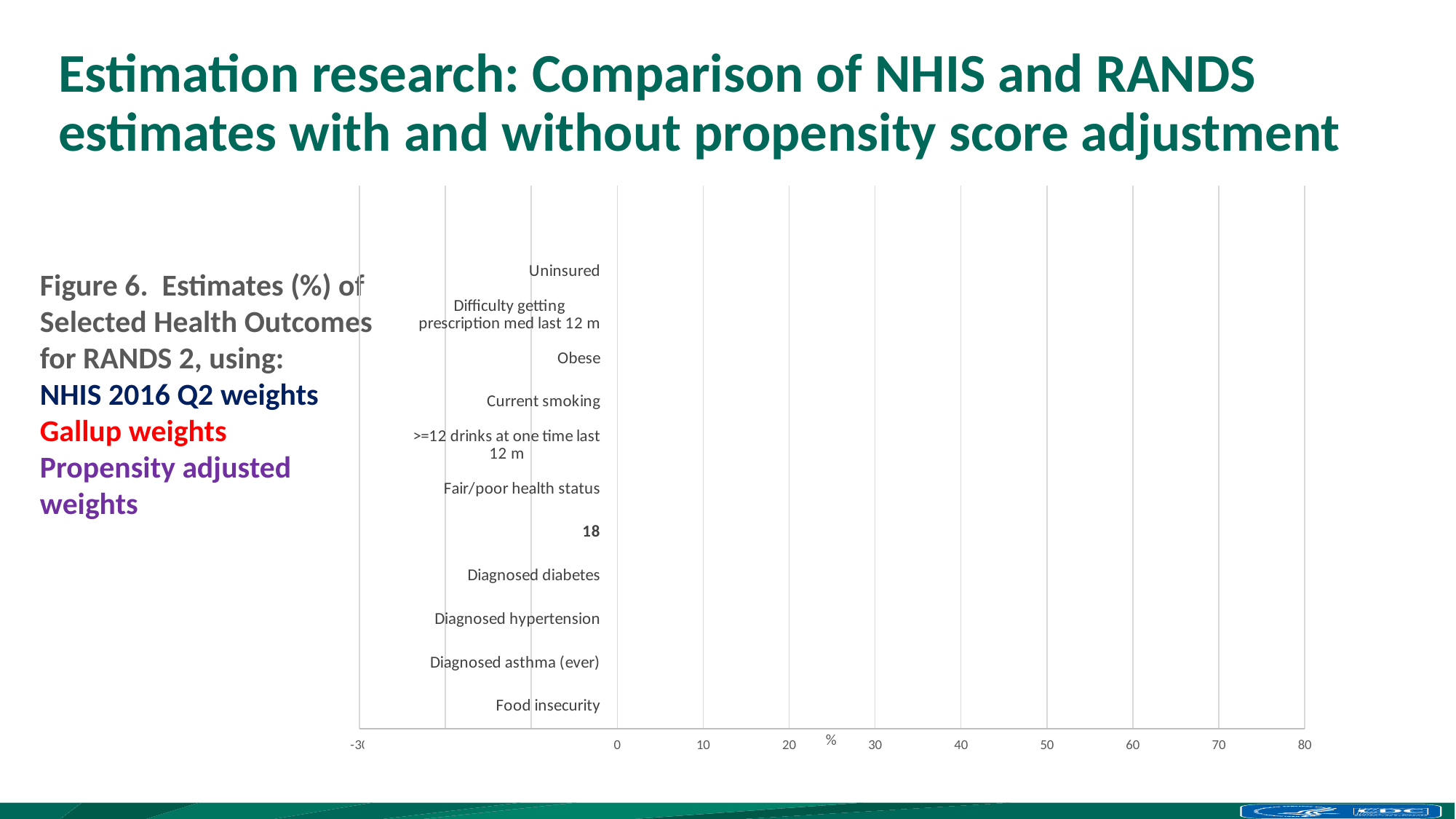
Which category label appears at the bottom of the chart's vertical axis? Food insecurity What is the label shown on the horizontal axis of the chart? % Which category label appears at the top of the chart's vertical axis? Uninsured What figure number is given in the caption to the left of the chart? Figure 6 What is the highest tick value shown on the horizontal axis of the chart? 80